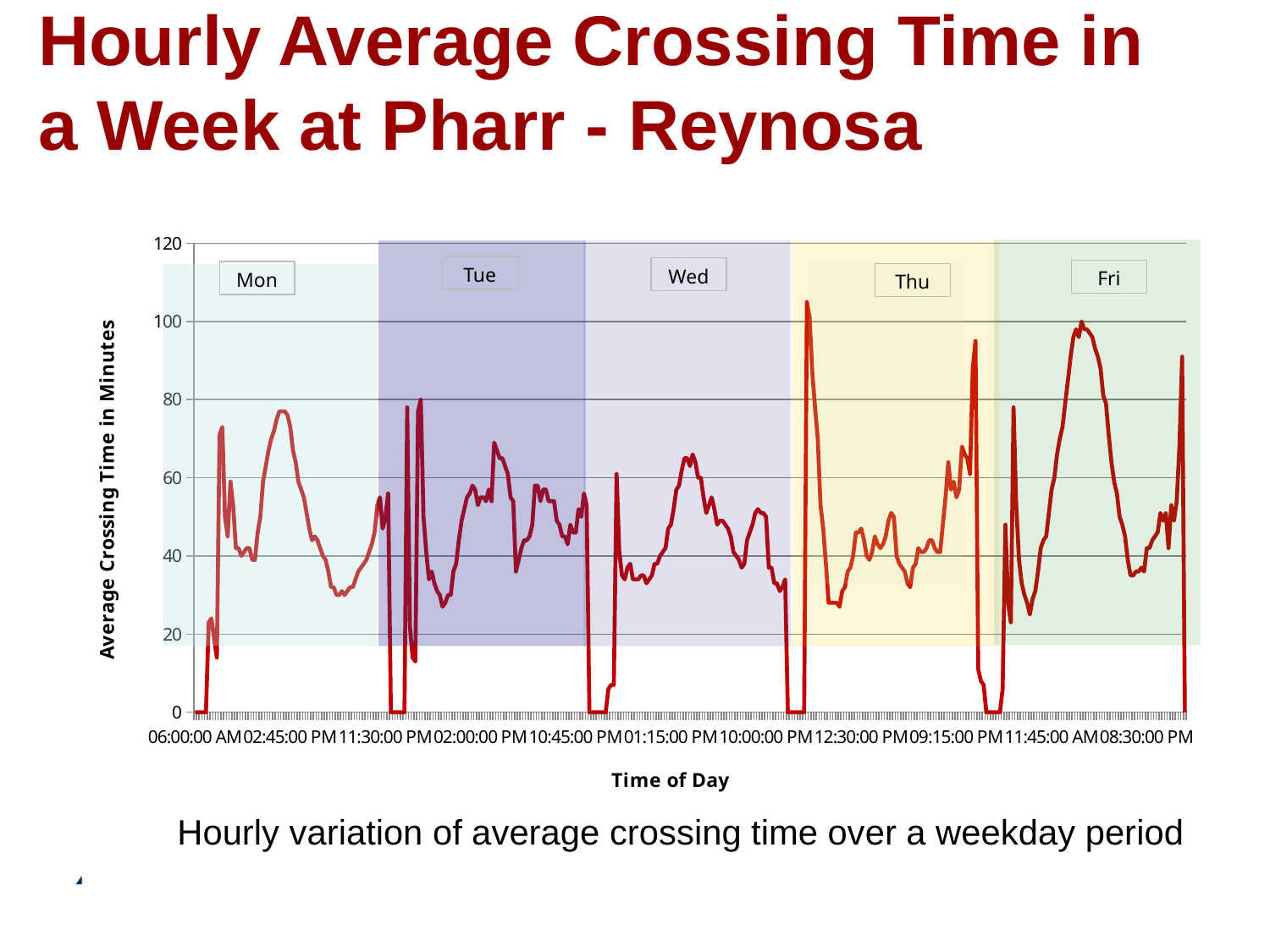
How many days are labelled across the chart? 5 Which day's peak is higher, Friday or Wednesday? Fri What is the label of the vertical axis? Average Crossing Time in Minutes Is the peak crossing time on Thursday larger than the peak on Monday? Yes Is the peak crossing time on Monday greater or less than 60 minutes? greater What is the highest value shown on the vertical axis? 120 What kind of chart is shown on the slide? line chart Is the peak crossing time on Thursday greater or less than 80 minutes? greater Is the peak crossing time on Monday greater or less than 80 minutes? less Which day has the lowest peak crossing time? Wed